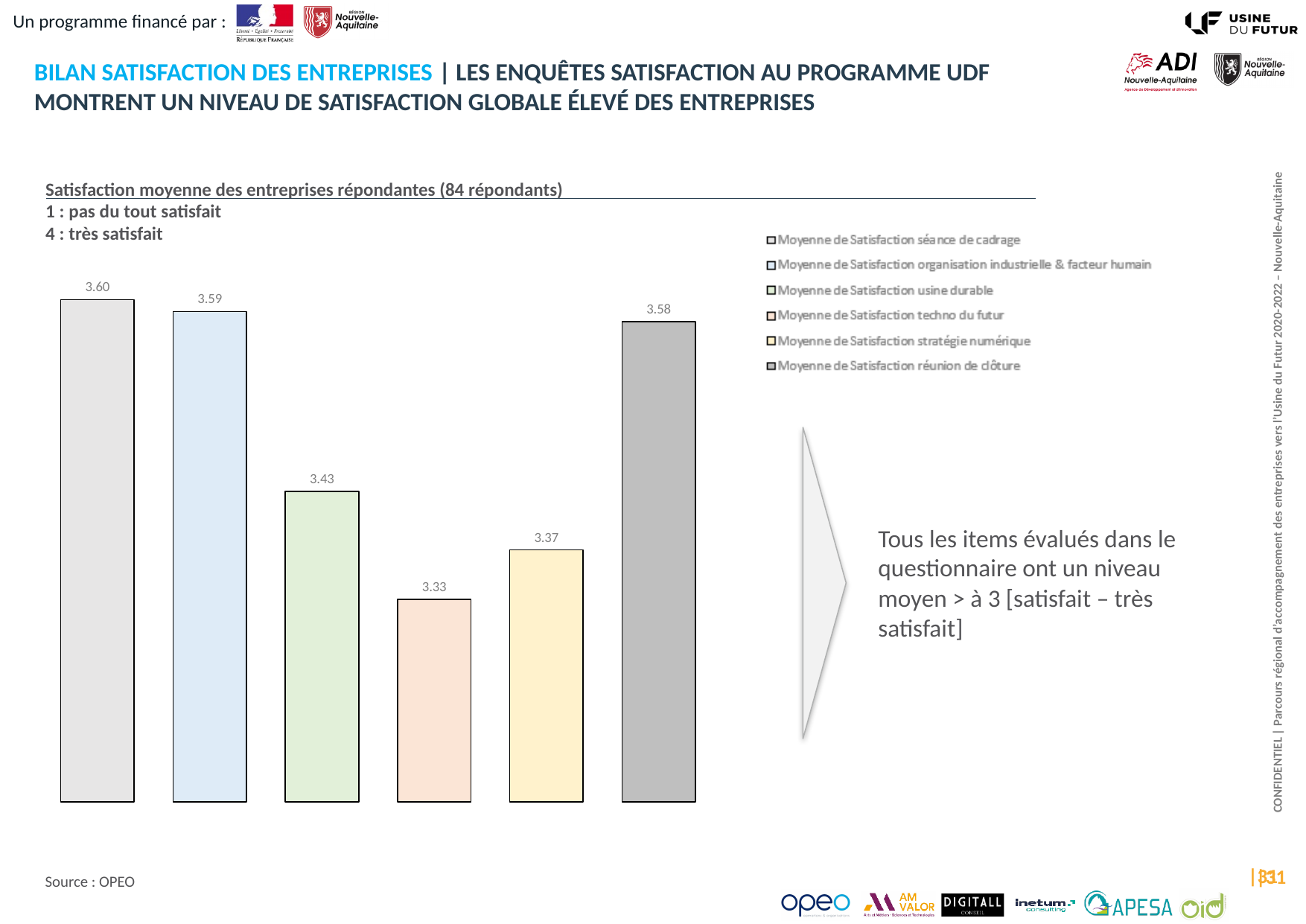
What is the average satisfaction value for 'Moyenne de Satisfaction usine durable'? 3.43 Which is larger: the average satisfaction for 'usine durable' or for 'stratégie numérique'? usine durable Which item has the lowest average satisfaction? Moyenne de Satisfaction techno du futur What is the average satisfaction value for 'Moyenne de Satisfaction réunion de clôture'? 3.58 What is the average satisfaction value for 'Moyenne de Satisfaction séance de cadrage'? 3.60 Which item has the highest average satisfaction? Moyenne de Satisfaction séance de cadrage How many series does the legend list? 6 How many respondents does the chart title say the averages are based on? 84 répondants What kind of chart is shown on the slide? Bar chart What is the average satisfaction value for 'Moyenne de Satisfaction techno du futur'? 3.33 How many bars are plotted in the chart? 6 What is the difference between the average satisfaction for 'séance de cadrage' and 'techno du futur'? 0.27